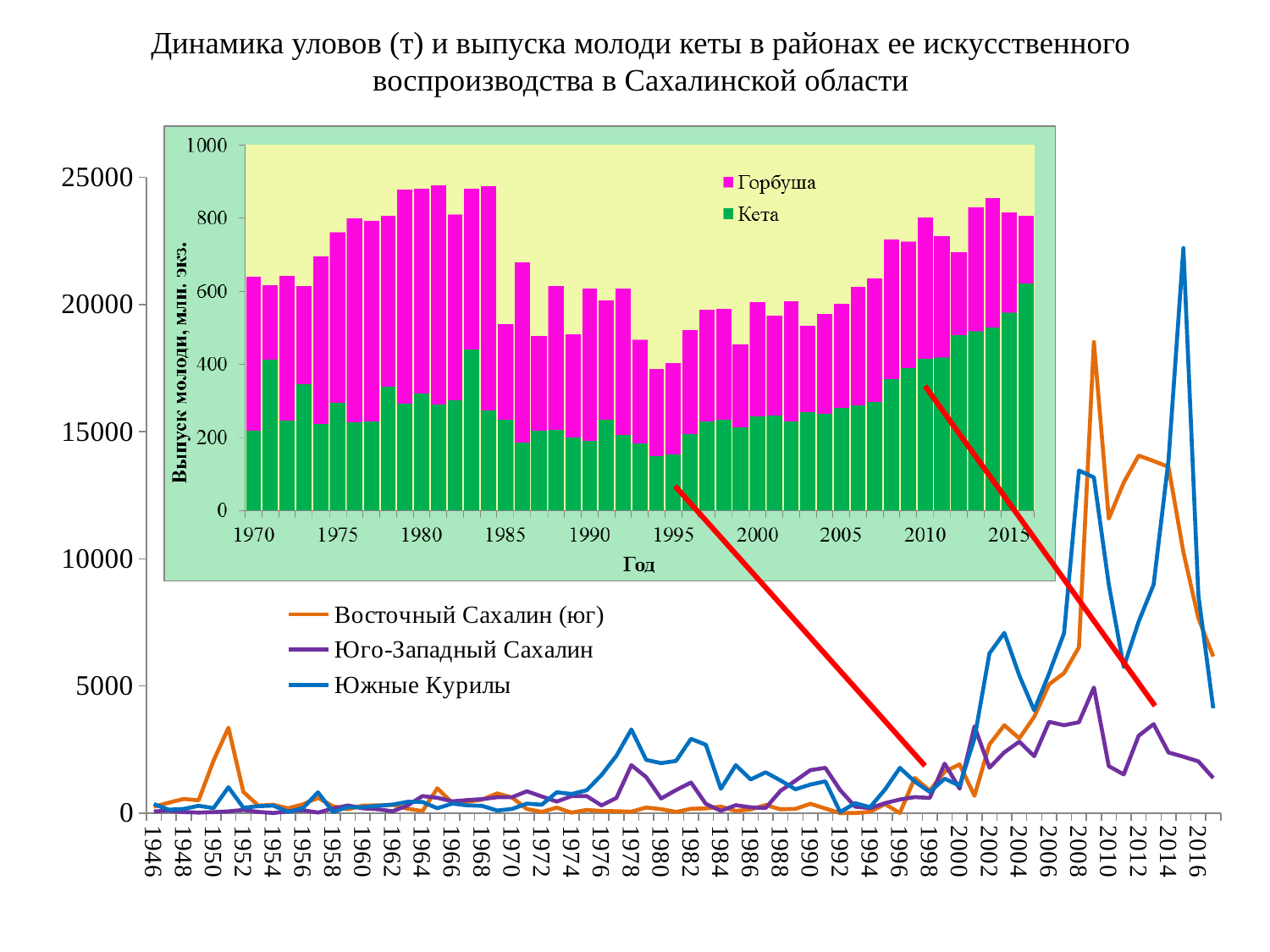
On the inset bar chart, is the value for Кета in 2016 greater or less than 400? greater On the inset bar chart, does the Кета series rise or fall from 2010 to 2016? rise On the large line chart, how many series does the legend list? 3 On the inset bar chart, how many series does the legend list? 2 On the inset bar chart, what is the label of the vertical axis? Выпуск молоди, млн. экз. On the large line chart, is the value for Южные Курилы in 2015 greater or less than 20000? greater On the large line chart, is the value for Юго-Западный Сахалин in 2009 greater or less than 10000? less On the inset chart (top), what kind of chart is it? bar chart On the large chart with the years 1946–2016 along the x axis, what kind of chart is it? line chart On the large line chart, which is larger in 2009: Восточный Сахалин (юг) or Юго-Западный Сахалин? Восточный Сахалин (юг) On the large line chart, which series reaches the highest value? Южные Курилы